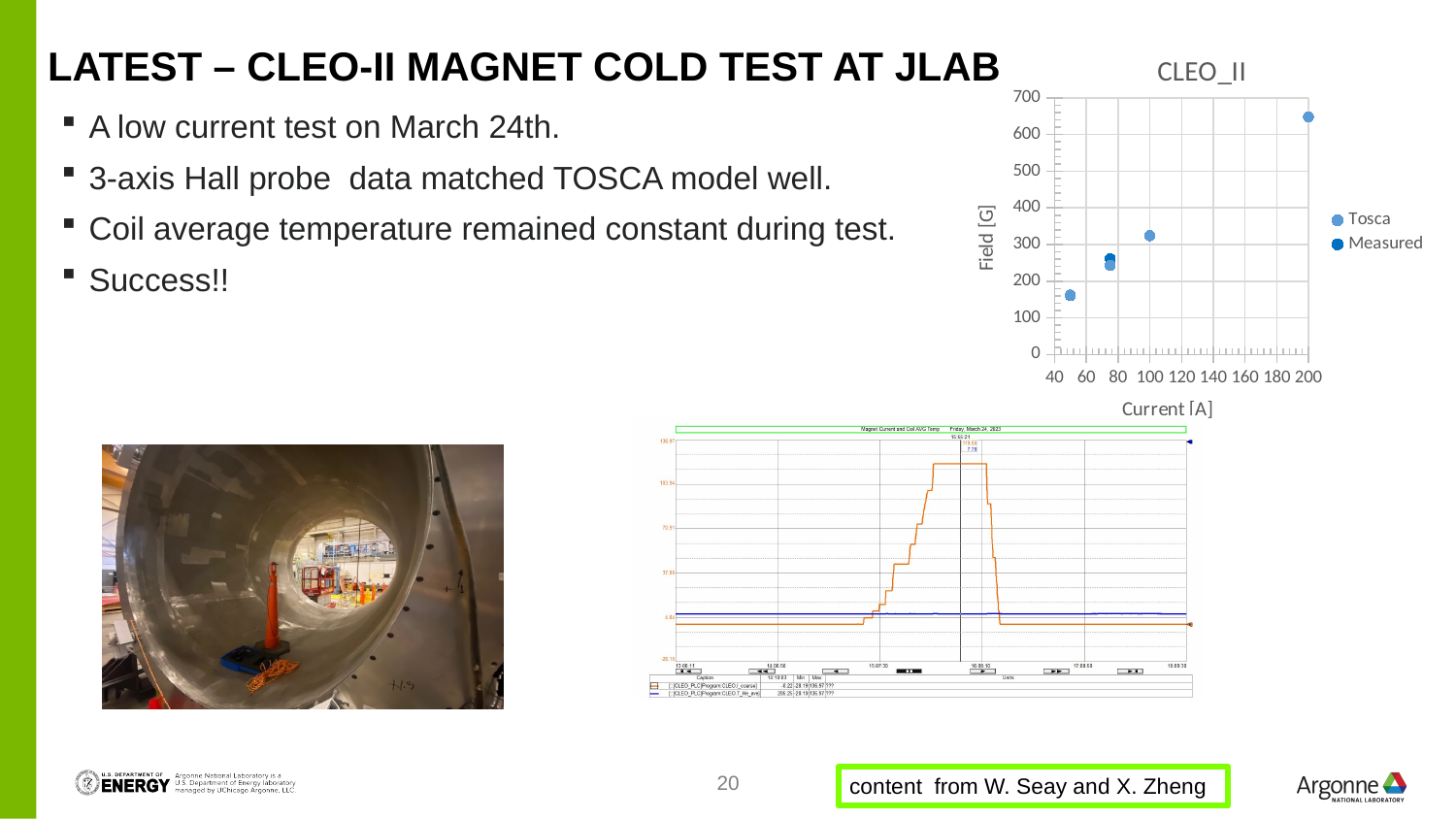
In the CLEO_II chart, which has the larger field value: the point at 200 A or the point at 100 A? the point at 200 A What kind of chart is the CLEO_II chart? scatter chart In the CLEO_II chart, is the field value at the lowest plotted current (around 50 A) greater or less than 200 G? less In the CLEO_II chart, do the field values rise or fall as current increases along the x axis? rise In the CLEO_II chart, at which current is the highest field value plotted? 200 A In the CLEO_II chart, is the field value at 200 A greater or less than 700 G? less In the CLEO_II chart, is the field value at 100 A greater or less than 400 G? less How many series does the legend of the CLEO_II chart list? 2 What are the two series named in the legend of the CLEO_II chart? Tosca and Measured What is the title of the scatter chart on the slide? CLEO_II